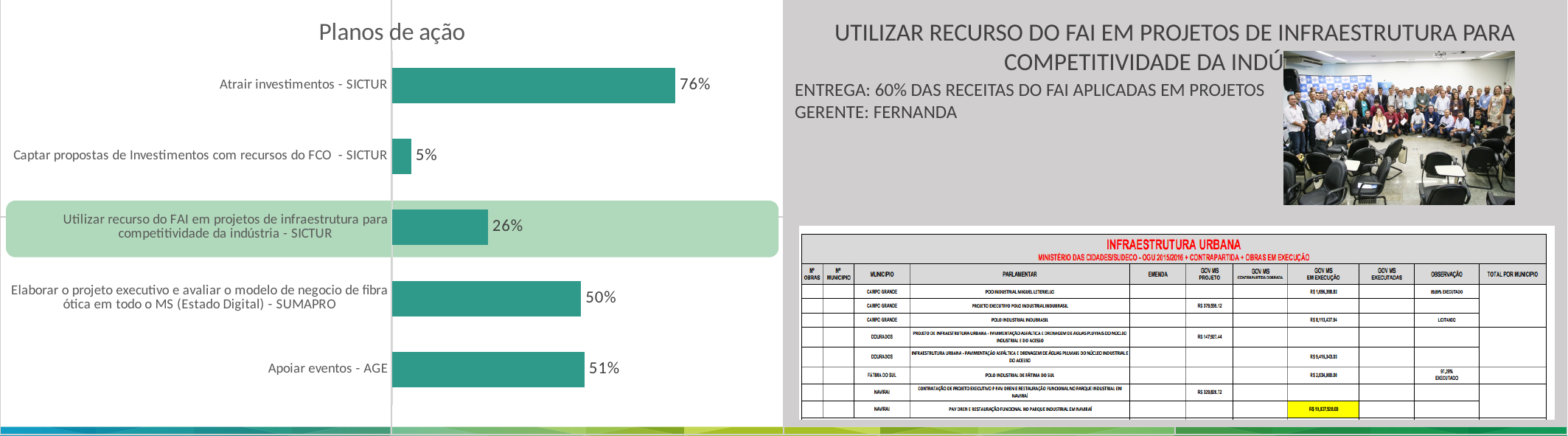
What is the value for "Utilizar recurso do FAI em projetos de infraestrutura para competitividade da indústria - SICTUR"? 26% How many categories are plotted in the chart? 5 What is the value for "Apoiar eventos - AGE"? 51% What is the value for "Captar propostas de Investimentos com recursos do FCO - SICTUR"? 5% What is the difference between the values for "Atrair investimentos - SICTUR" and "Utilizar recurso do FAI em projetos de infraestrutura para competitividade da indústria - SICTUR"? 50% What type of chart is shown under the title "Planos de ação"? bar chart What is the value for "Elaborar o projeto executivo e avaliar o modelo de negocio de fibra ótica em todo o MS (Estado Digital) - SUMAPRO"? 50% Which category has the lowest value in the chart? Captar propostas de Investimentos com recursos do FCO - SICTUR Which is larger: the value for "Atrair investimentos - SICTUR" or the value for "Apoiar eventos - AGE"? Atrair investimentos - SICTUR What is the title of the chart? Planos de ação What is the value for "Atrair investimentos - SICTUR"? 76% Which category has the highest value in the chart? Atrair investimentos - SICTUR